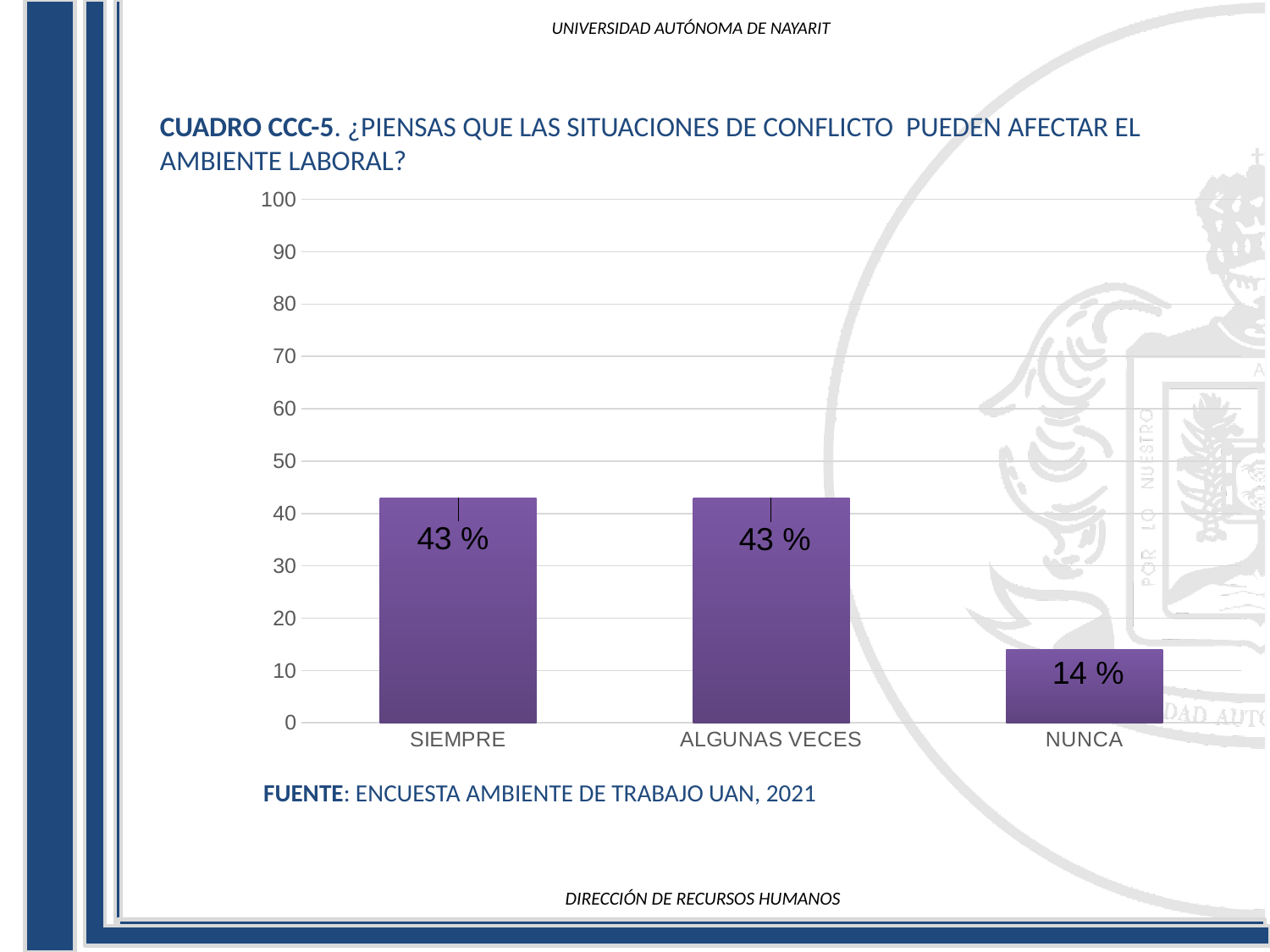
What is the source cited below the chart? ENCUESTA AMBIENTE DE TRABAJO UAN, 2021 Which category has the lowest value? NUNCA What is the value for SIEMPRE? 43 % Is the value for SIEMPRE greater or less than 40? greater What is the value for NUNCA? 14 % What kind of chart is shown on the slide? bar chart What is the difference between the values for SIEMPRE and NUNCA? 29 % Is the value for NUNCA greater or less than 20? less What is the value for ALGUNAS VECES? 43 % Which is larger, the value for ALGUNAS VECES or the value for NUNCA? ALGUNAS VECES How many categories are shown on the x axis? 3 What is the highest value shown on the y axis? 100